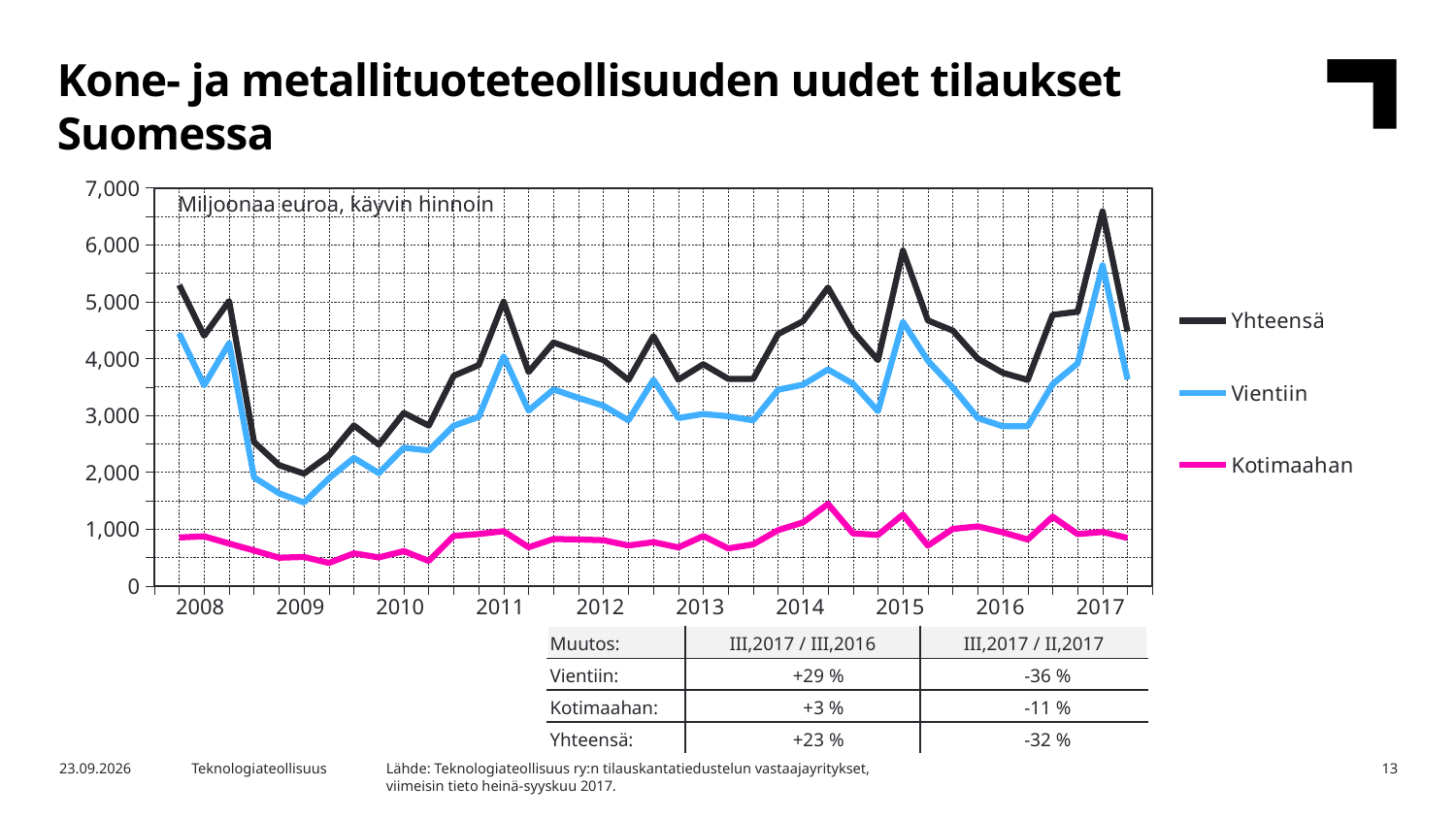
What kind of chart is shown on the slide? line chart Which series has the lowest values across the whole chart? Kotimaahan Is the highest value of Kotimaahan on the chart greater or less than 2,000? less Does the Yhteensä line rise or fall from the start of 2008 to 2009? fall Is the peak value of Yhteensä in 2017 greater or less than 6,000? greater Is the peak value of Vientiin in 2017 greater or less than 5,000? greater How many series does the legend list? 3 What unit label is printed inside the chart area? Miljoonaa euroa, käyvin hinnoin What are the three series named in the legend? Yhteensä, Vientiin, Kotimaahan Which series has the highest values across the whole chart? Yhteensä How many years are labelled on the x axis? 10